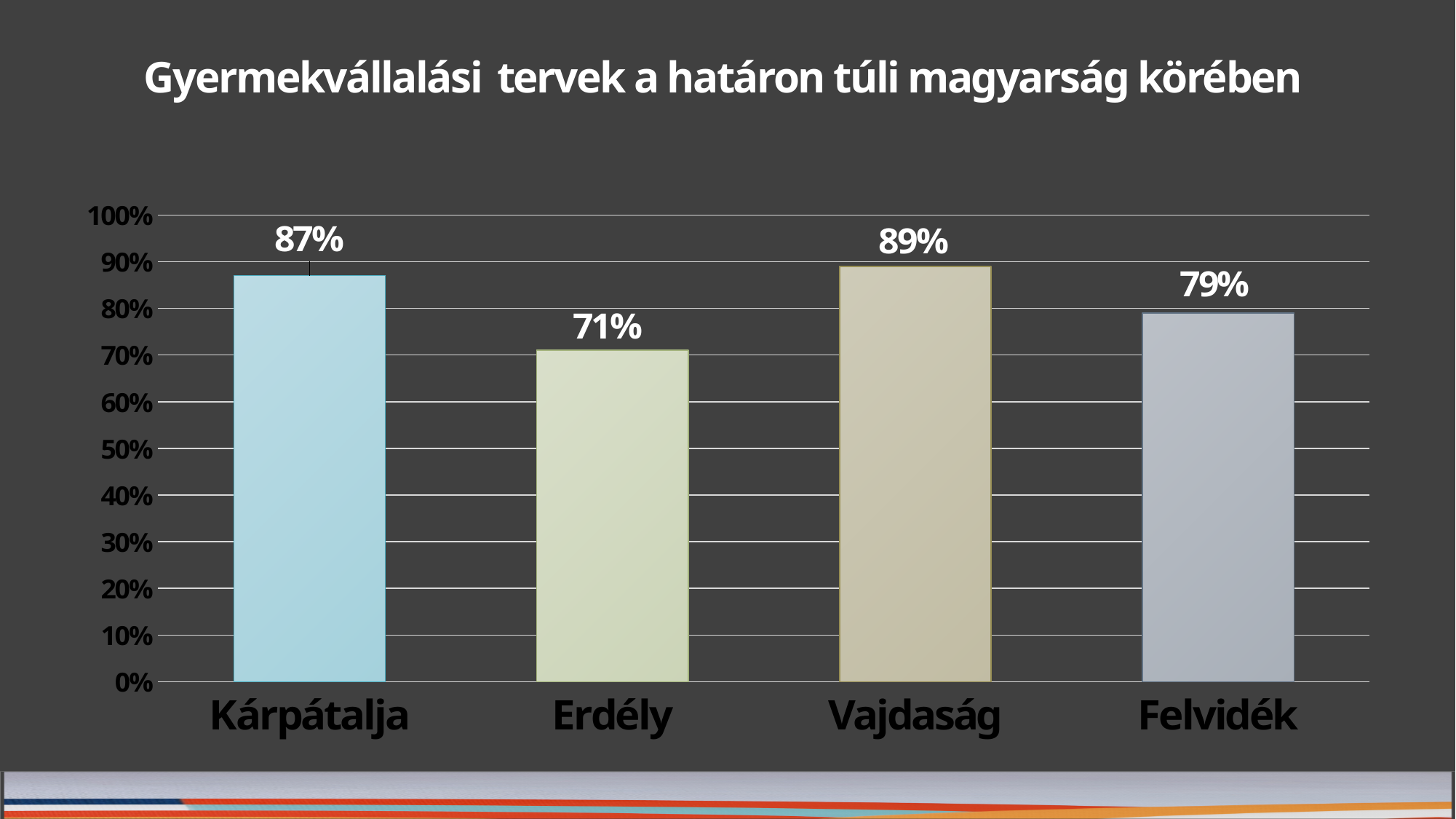
What is the value for Erdély? 71% Which category has the highest value? Vajdaság What is the value for Vajdaság? 89% What kind of chart is shown on the slide? bar chart What is the value for Felvidék? 79% Is the value for Felvidék greater or less than 80%? less Which category has the lowest value? Erdély How many categories are shown on the x axis? 4 What is the difference between the values for Kárpátalja and Felvidék? 8% What is the value for Kárpátalja? 87% What is the difference between the values for Vajdaság and Erdély? 18% Which is larger, the value for Felvidék or the value for Erdély? Felvidék